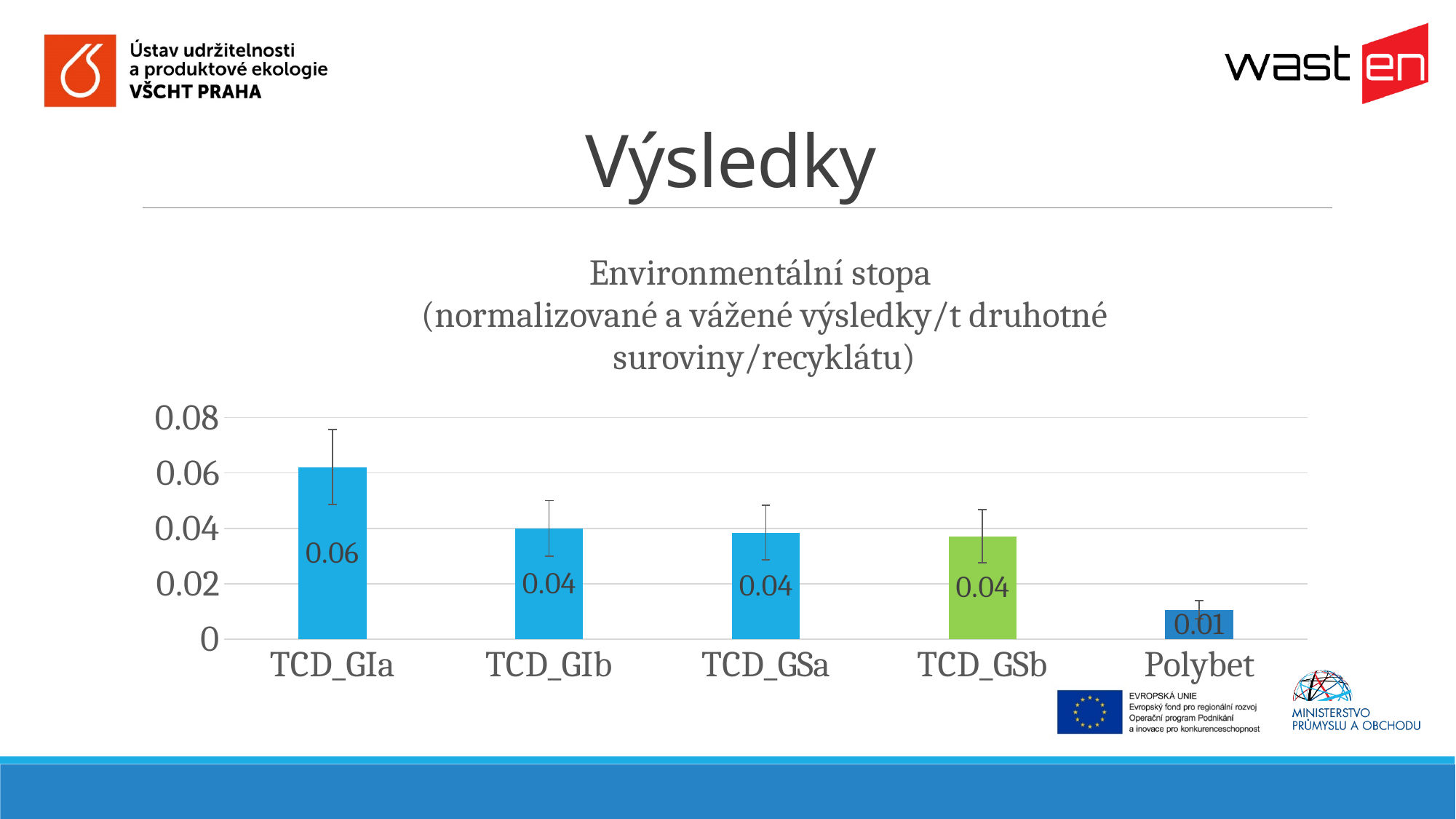
Is the value for TCD_GIa greater or less than 0.04? greater Is the value for Polybet greater or less than 0.02? less Which category has the lowest value? Polybet How many categories are shown on the x axis? 5 What is the value shown for Polybet? 0.01 What kind of chart is shown on the slide? bar chart Which bar is coloured green rather than blue? TCD_GSb What is the difference between the values for TCD_GIa and Polybet? 0.05 What is the value shown for TCD_GIa? 0.06 Which is larger, the value for TCD_GIa or the value for TCD_GIb? TCD_GIa What is the value shown for TCD_GSb? 0.04 Which category has the highest value? TCD_GIa